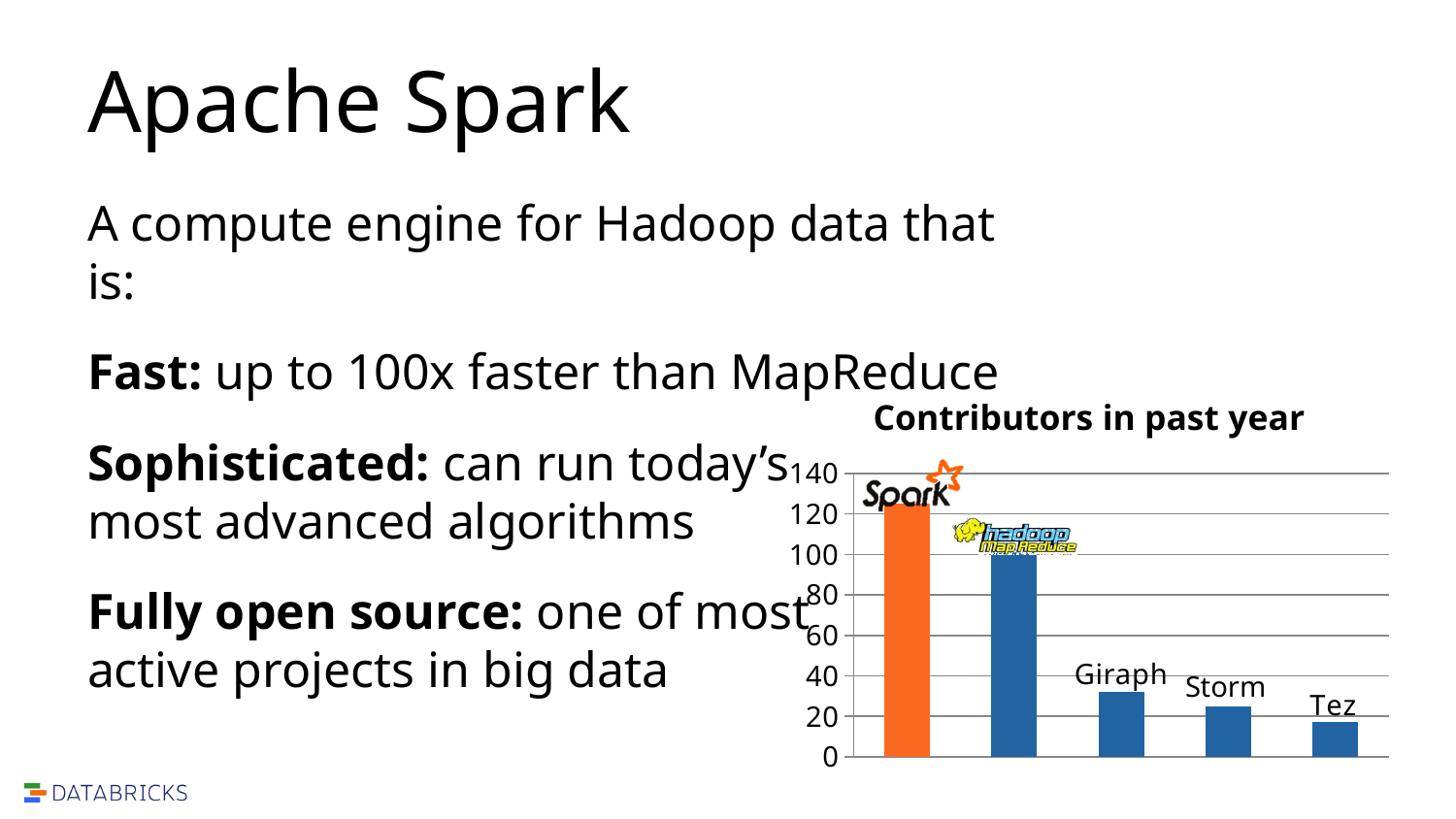
Which has more contributors, Spark or Hadoop MapReduce? Spark What is the title of the chart? Contributors in past year How many projects (bars) are shown in the chart? 5 Is the value for Giraph greater or less than 20? greater What kind of chart is shown on the slide? bar chart Is the value for Tez greater or less than 20? less Which project has the lowest number of contributors in the past year? Tez Which project has the highest number of contributors in the past year? Spark Is the value for Hadoop MapReduce greater or less than 80? greater What colour is the Spark bar? orange Do the bar values rise or fall from left to right across the chart? fall